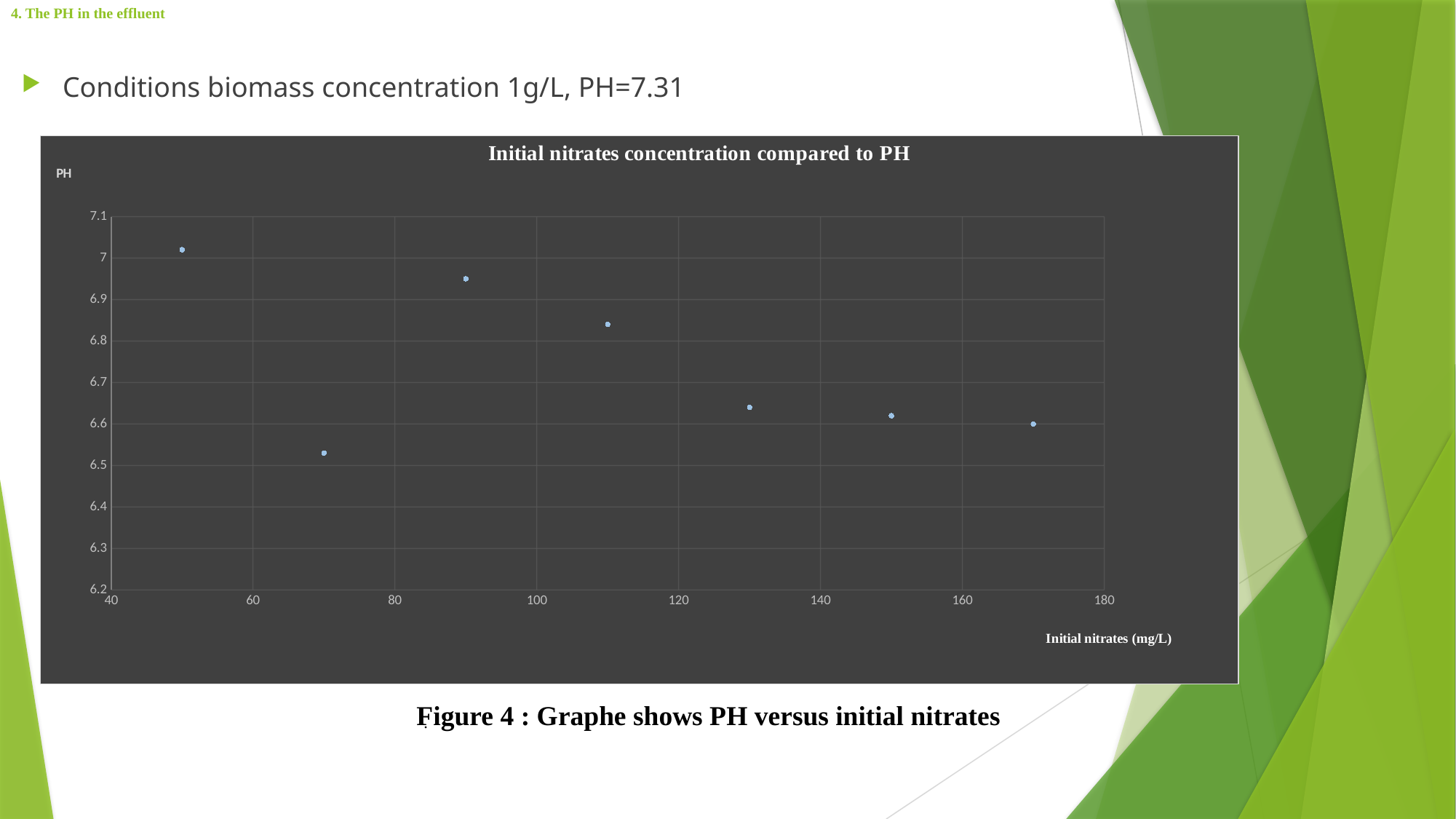
Which has the higher PH: the point at 70 mg/L or the point at 130 mg/L initial nitrates? 130 mg/L Which has the higher PH: the point at 90 mg/L or the point at 110 mg/L initial nitrates? 90 mg/L Is the PH value at 70 mg/L initial nitrates greater or less than 6.6? less Is the PH value at 90 mg/L initial nitrates greater or less than 6.9? greater Is the PH value at 110 mg/L initial nitrates greater or less than 6.8? greater At which initial nitrates concentration is the PH highest? 50 What is the title of the chart? Initial nitrates concentration compared to PH What kind of chart is shown on the slide? Scatter chart What is the label of the x axis of the chart? Initial nitrates (mg/L) At which initial nitrates concentration is the PH lowest? 70 How many data points are plotted in the chart? 7